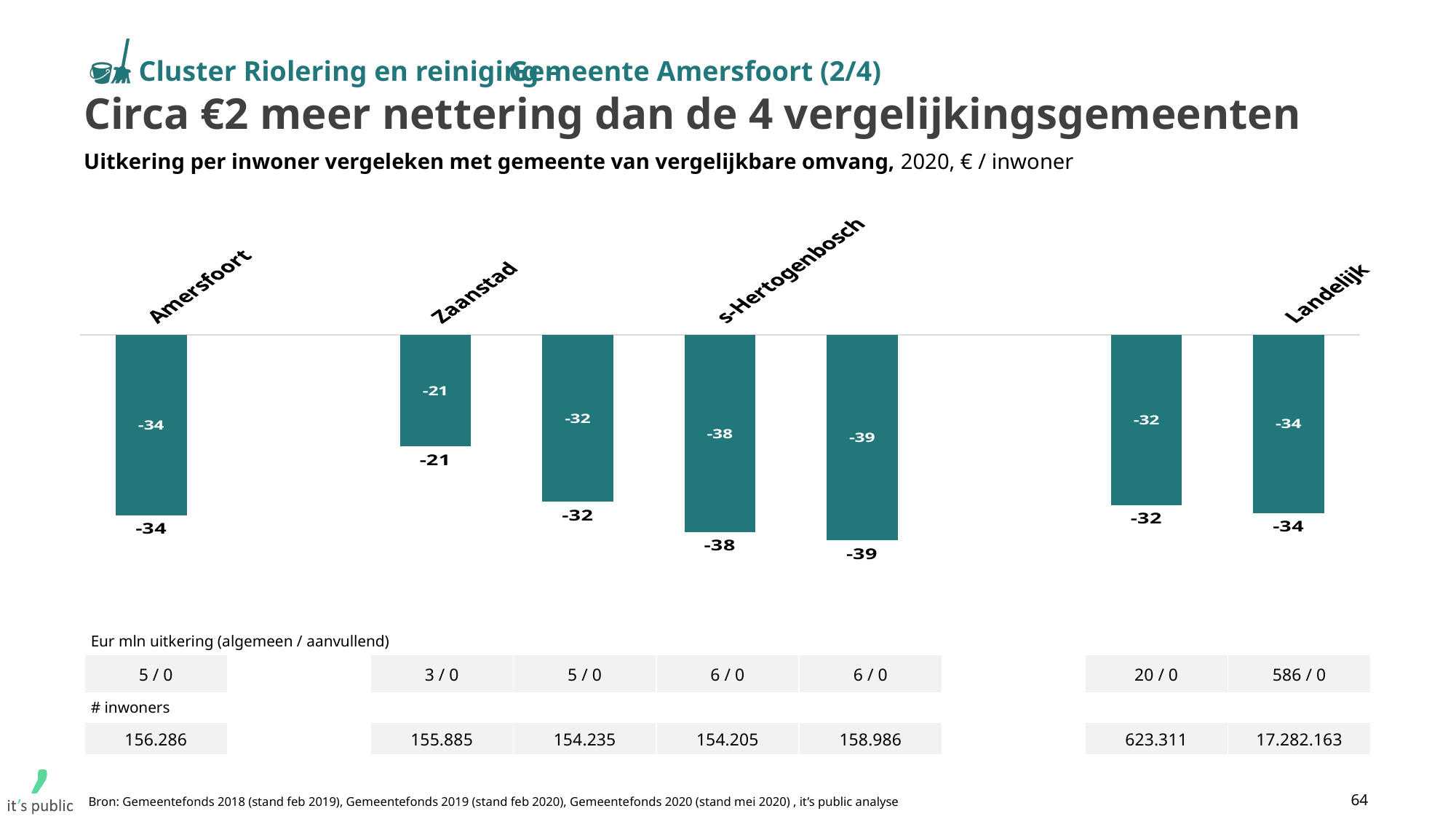
What is the difference between the values for 's-Hertogenbosch and Landelijk? 4 What is the lowest value shown on the chart? -39 What is the difference between the values for Amersfoort and Zaanstad? 13 What is the value for Landelijk? -34 Which labelled category has the highest (least negative) value? Zaanstad Which is larger, the value for Zaanstad or the value for Amersfoort? Zaanstad How many bars are plotted on the chart? 7 What is the value for 's-Hertogenbosch? -38 What is the value for Zaanstad? -21 What unit is stated in the chart subtitle? € / inwoner What is the value for Amersfoort? -34 What kind of chart is shown on the slide? Bar chart